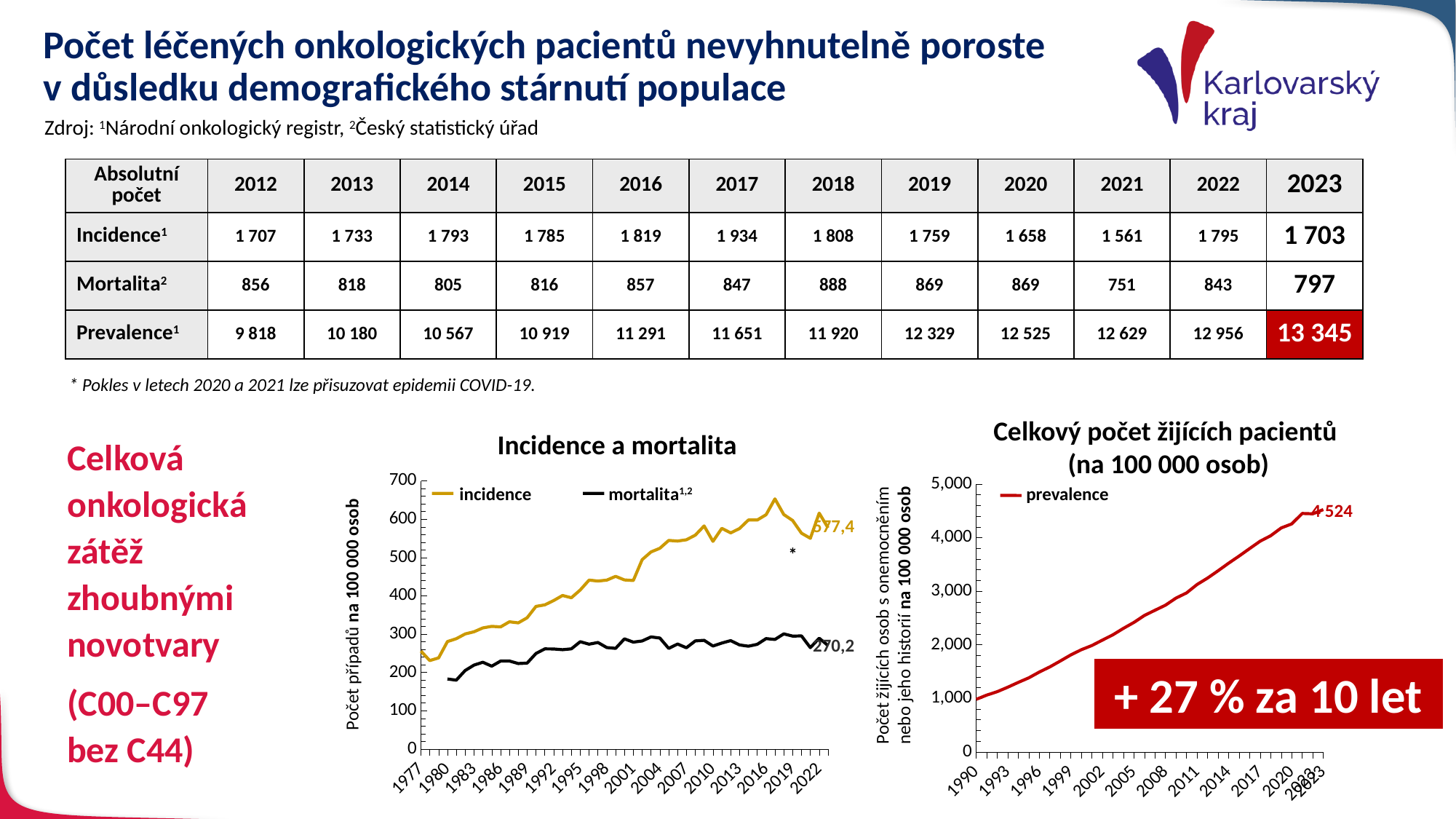
In the "Celkový počet žijících pacientů (na 100 000 osob)" chart, what is the labelled value at the end of the prevalence line? 4 524 In the "Incidence a mortalita" chart, what is the labelled value at the end of the mortalita line? 270,2 In the "Incidence a mortalita" chart, is the incidence value in 1977 greater or less than 300? less In the "Incidence a mortalita" chart, what is the difference between the final labelled incidence value and the final labelled mortalita value? 307,2 What kind of chart is the "Incidence a mortalita" chart? line chart In the "Incidence a mortalita" chart, which series has the higher final labelled value, incidence or mortalita? incidence In the "Incidence a mortalita" chart, does the incidence line generally rise or fall from 1977 to 2022? rise In the "Celkový počet žijících pacientů (na 100 000 osob)" chart, is the prevalence value in 2014 greater or less than 3,000? greater What colour is the prevalence line in the "Celkový počet žijících pacientů (na 100 000 osob)" chart? red How many series does the legend of the "Incidence a mortalita" chart list? 2 In the "Incidence a mortalita" chart, what is the labelled value at the end of the incidence line? 577,4 In the "Celkový počet žijících pacientů (na 100 000 osob)" chart, does the prevalence line rise or fall over time? rise